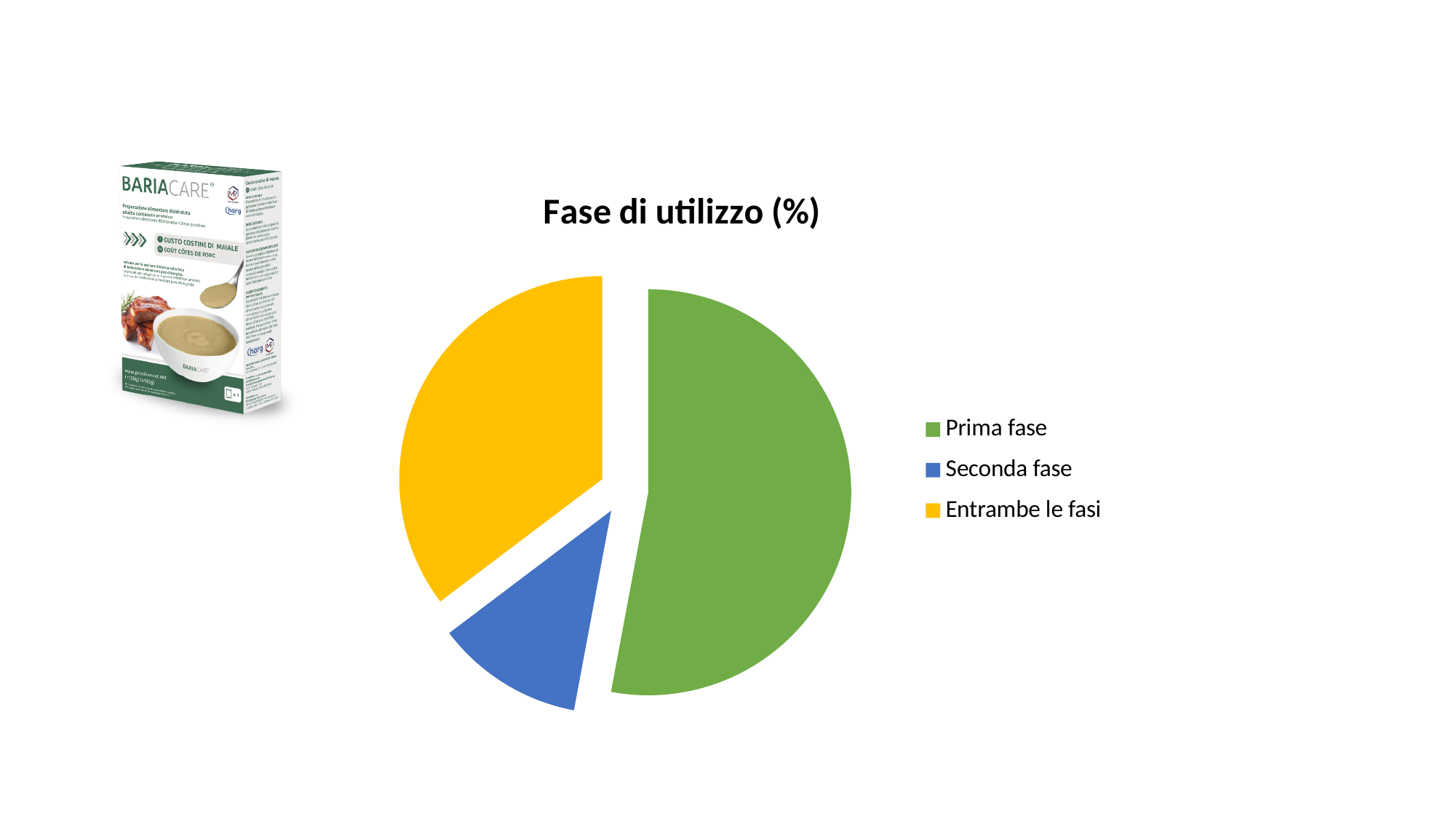
How many entries does the legend list? 3 Which slice is larger, Prima fase or Entrambe le fasi? Prima fase What is the title of the chart? Fase di utilizzo (%) Which slice is larger, Prima fase or Seconda fase? Prima fase Which slice is larger, Seconda fase or Entrambe le fasi? Entrambe le fasi Which category has the smallest slice of the pie? Seconda fase What colour is the slice for Entrambe le fasi? Yellow Which category has the largest slice of the pie? Prima fase How many slices does the pie chart have? 3 What kind of chart is shown on the slide? Pie chart